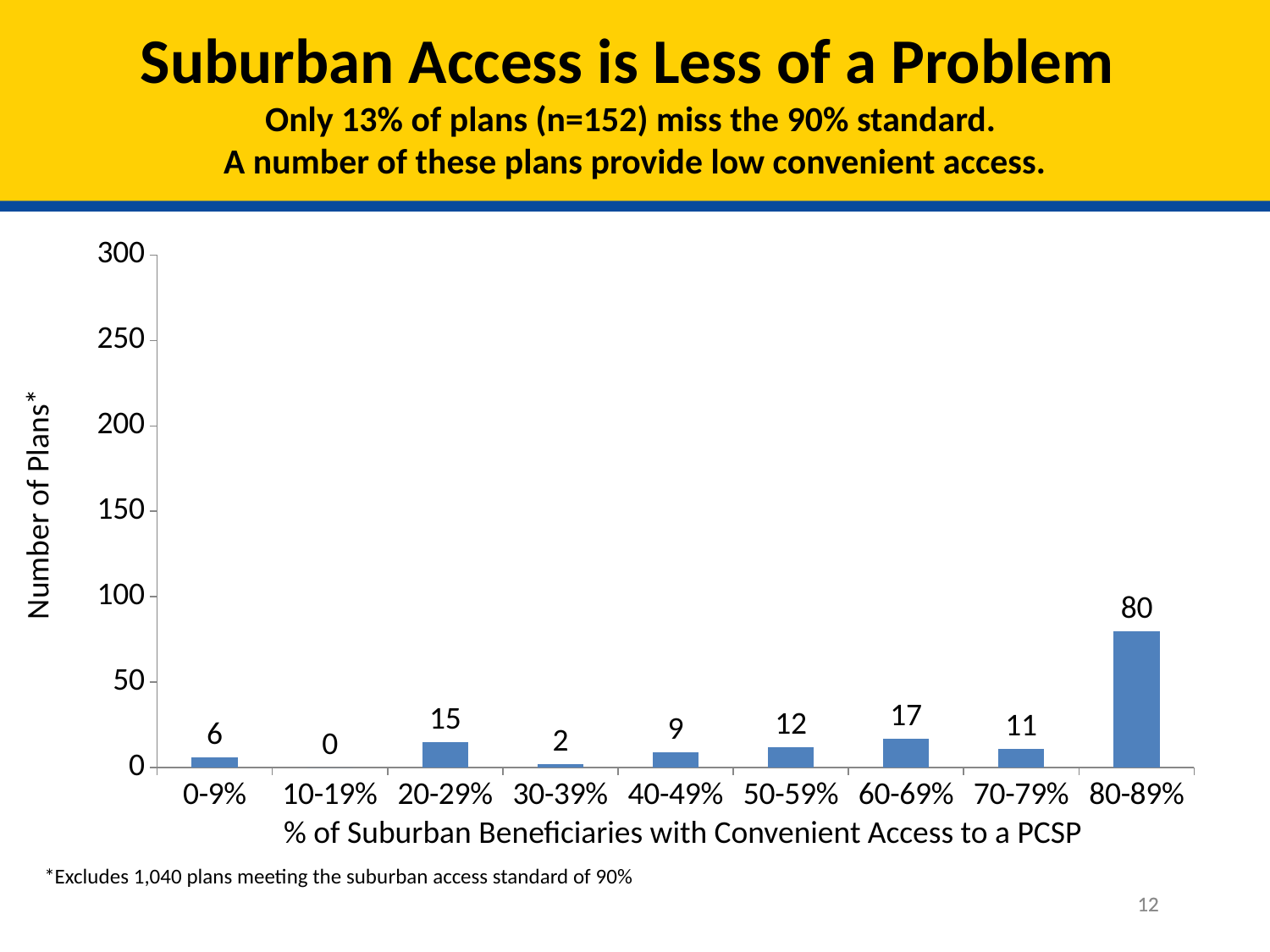
Which category has the lowest number of plans? 10-19% What is the label of the y axis? Number of Plans* Which category has the highest number of plans? 80-89% Is the value for the 80-89% category greater or less than 100? less How many categories are shown on the x axis? 9 Which category has more plans, 50-59% or 70-79%? 50-59% How many plans fall in the 10-19% category? 0 What is the number of plans for the 20-29% category? 15 What is the label of the x axis? % of Suburban Beneficiaries with Convenient Access to a PCSP How many plans are in the 80-89% category? 80 What type of chart is shown on the slide? bar chart What is the difference in number of plans between the 80-89% and 60-69% categories? 63